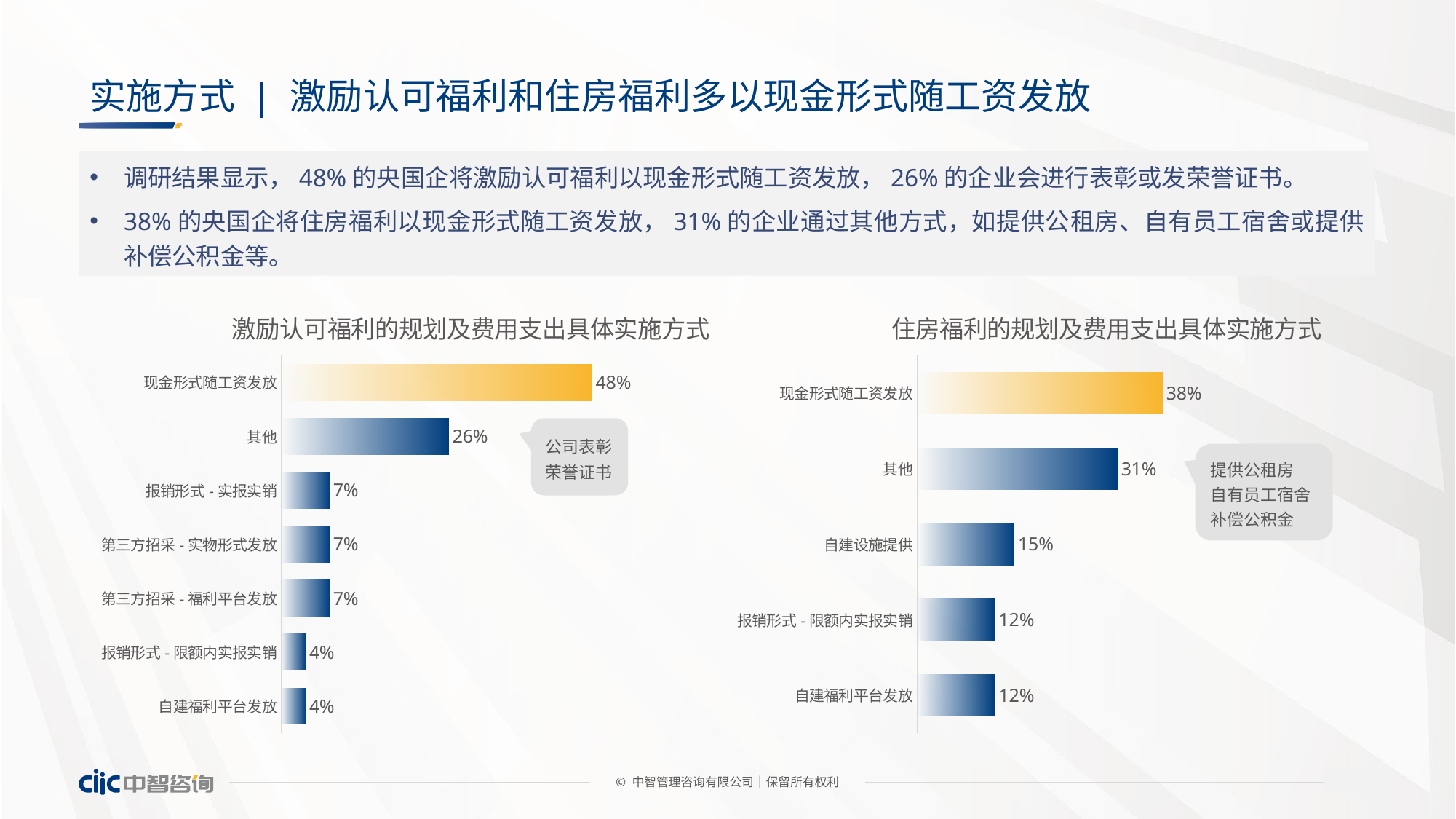
In the chart titled 住房福利的规划及费用支出具体实施方式, what is the value for 自建设施提供? 15% In the chart titled 激励认可福利的规划及费用支出具体实施方式, what is the difference between 现金形式随工资发放 and 其他? 22% In the chart titled 激励认可福利的规划及费用支出具体实施方式, how many categories are shown? 7 What kind of chart is the chart titled 激励认可福利的规划及费用支出具体实施方式? Bar chart In the chart titled 住房福利的规划及费用支出具体实施方式, which is larger, 其他 or 自建设施提供? 其他 In the chart titled 激励认可福利的规划及费用支出具体实施方式, what is the value for 现金形式随工资发放? 48% In the chart titled 激励认可福利的规划及费用支出具体实施方式, what is the value for 其他? 26% In the chart titled 住房福利的规划及费用支出具体实施方式, what is the value for 现金形式随工资发放? 38% In the chart titled 激励认可福利的规划及费用支出具体实施方式, which category has the lowest value? 报销形式 - 限额内实报实销 and 自建福利平台发放 (both 4%) In the chart titled 住房福利的规划及费用支出具体实施方式, which category has the highest value? 现金形式随工资发放 In the chart titled 住房福利的规划及费用支出具体实施方式, what is the difference between 现金形式随工资发放 and 其他? 7% In the chart titled 住房福利的规划及费用支出具体实施方式, how many categories are shown? 5